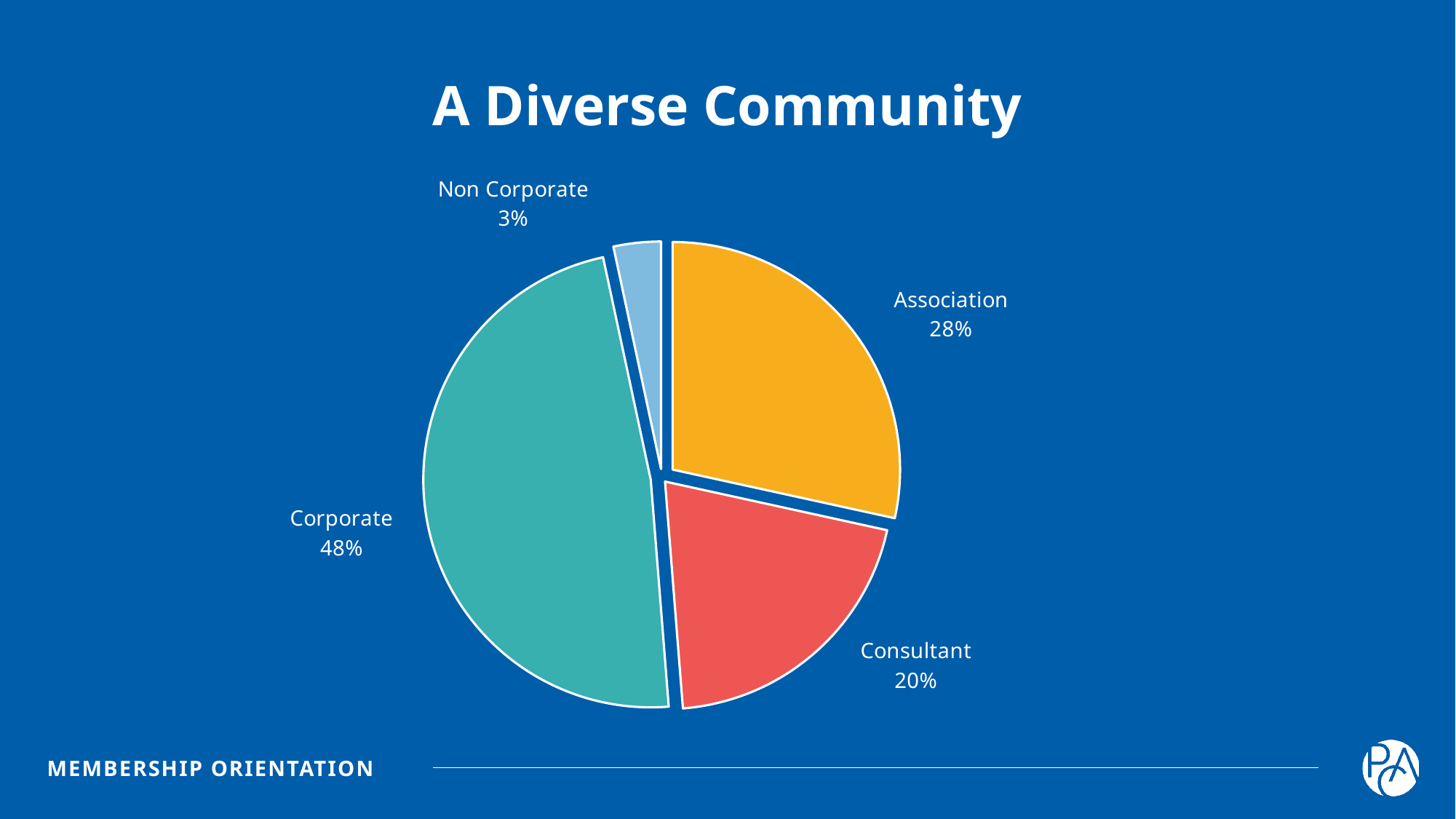
What share of the pie does Non Corporate represent? 3% How many categories are shown in the pie chart? 4 What is the difference in percentage points between Association and Consultant? 8 What share of the pie does Corporate represent? 48% What is the difference in percentage points between Corporate and Association? 20 Which is larger, the Consultant slice or the Association slice? Association What kind of chart is shown on the slide? pie chart What share of the pie does Consultant represent? 20% What share of the pie does Association represent? 28% Which category has the smallest slice of the pie? Non Corporate Which category has the largest slice of the pie? Corporate What is the title of the chart? A Diverse Community